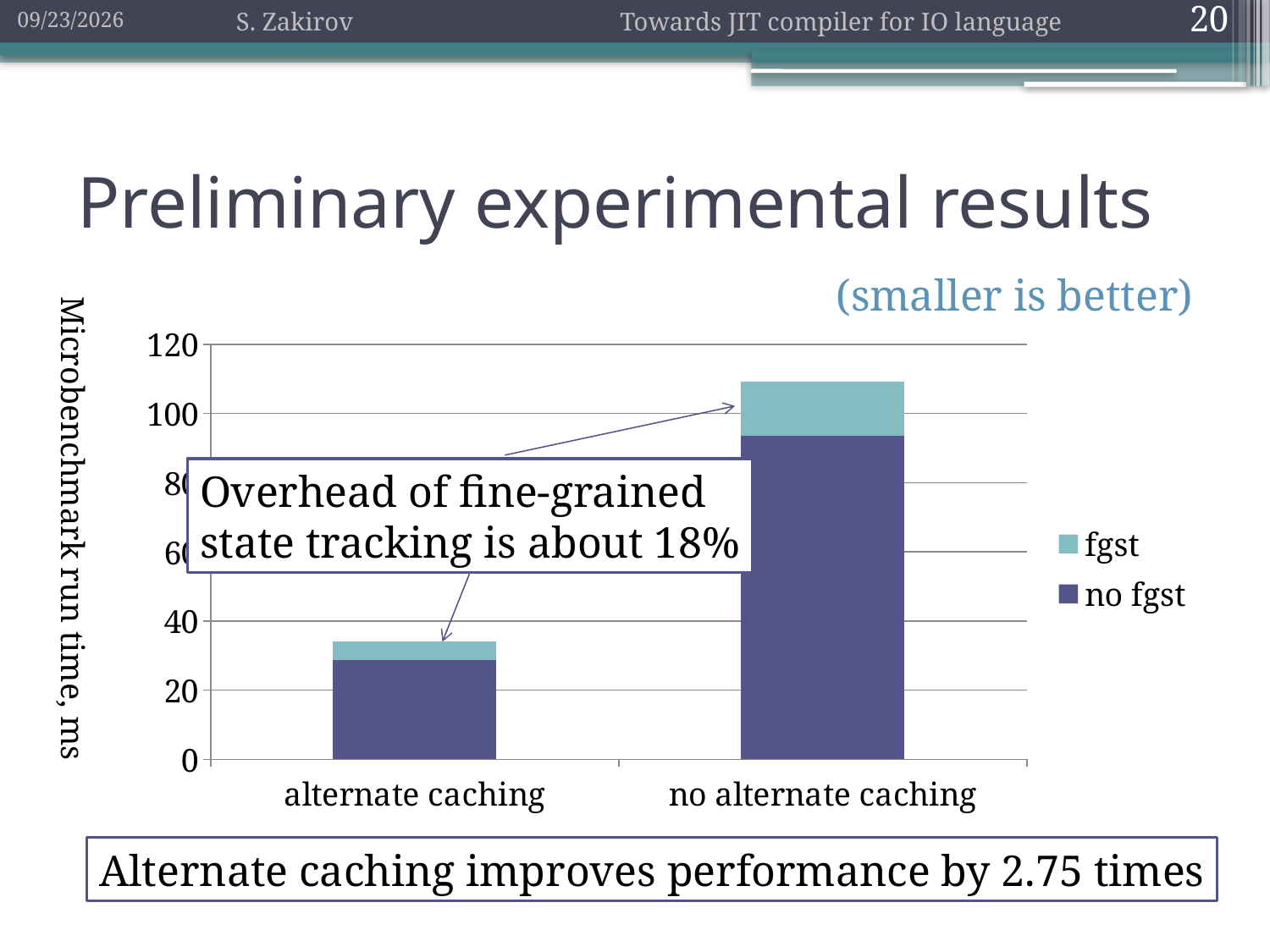
What kind of chart is shown on the slide? stacked bar chart How many categories are shown on the x axis of the chart? 2 Which category has the lowest total microbenchmark run time? alternate caching Is the total value for no alternate caching greater or less than 100? greater What is the title of the chart's vertical axis? Microbenchmark run time, ms How many series does the chart's legend list? 2 Which category has the highest total microbenchmark run time? no alternate caching Which has a larger total run time: alternate caching or no alternate caching? no alternate caching Is the 'no fgst' value for alternate caching greater or less than 20? greater Is the 'no fgst' value for no alternate caching greater or less than 80? greater Do the bar totals rise or fall from left to right along the x axis? rise